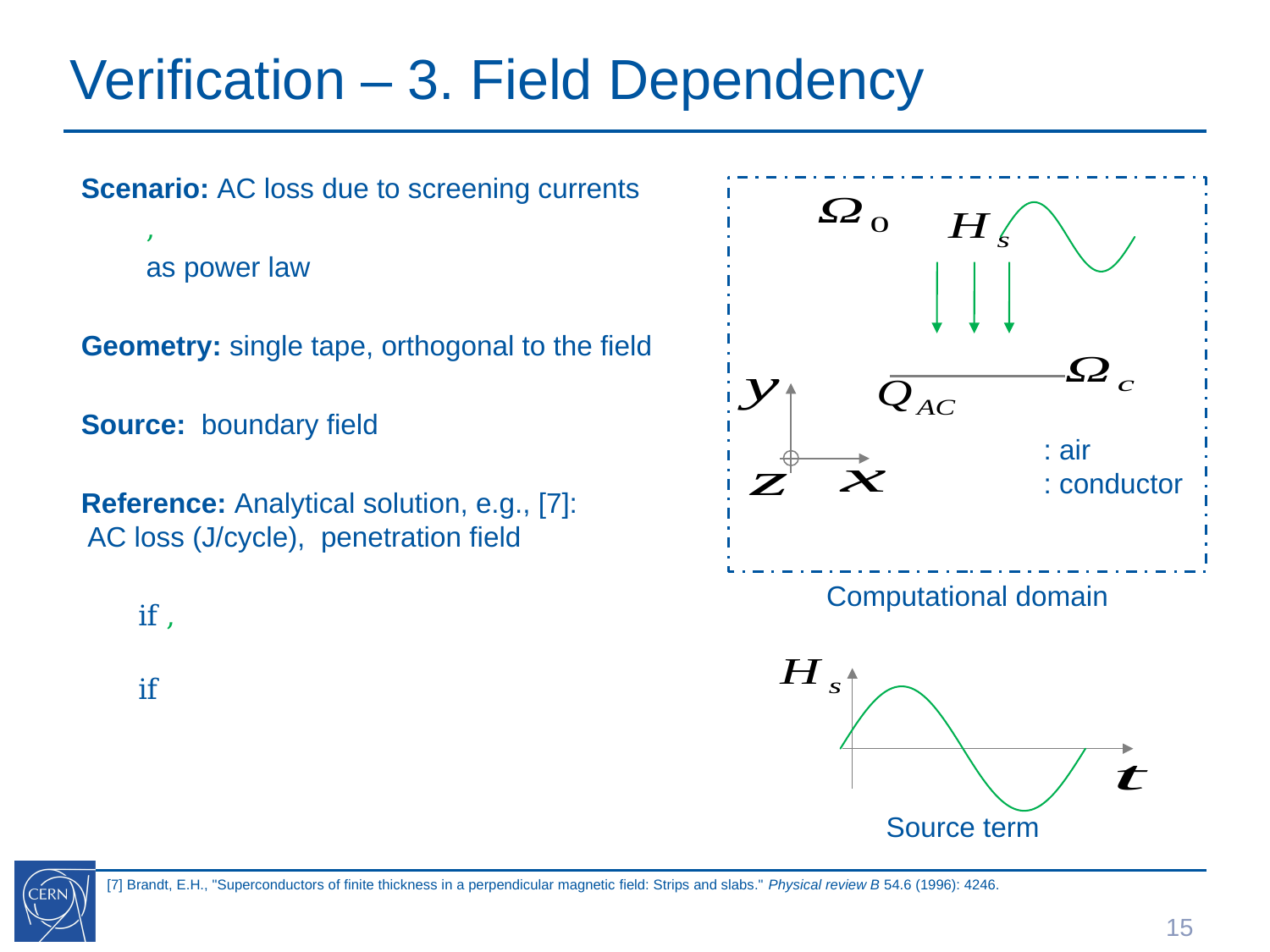
In the Source term plot at the bottom right, what is the label on the vertical axis? H_s In the Source term plot at the bottom right, what is the label on the horizontal axis? t In the Source term plot at the bottom right, does the curve first rise or first fall as t increases from the origin? rise